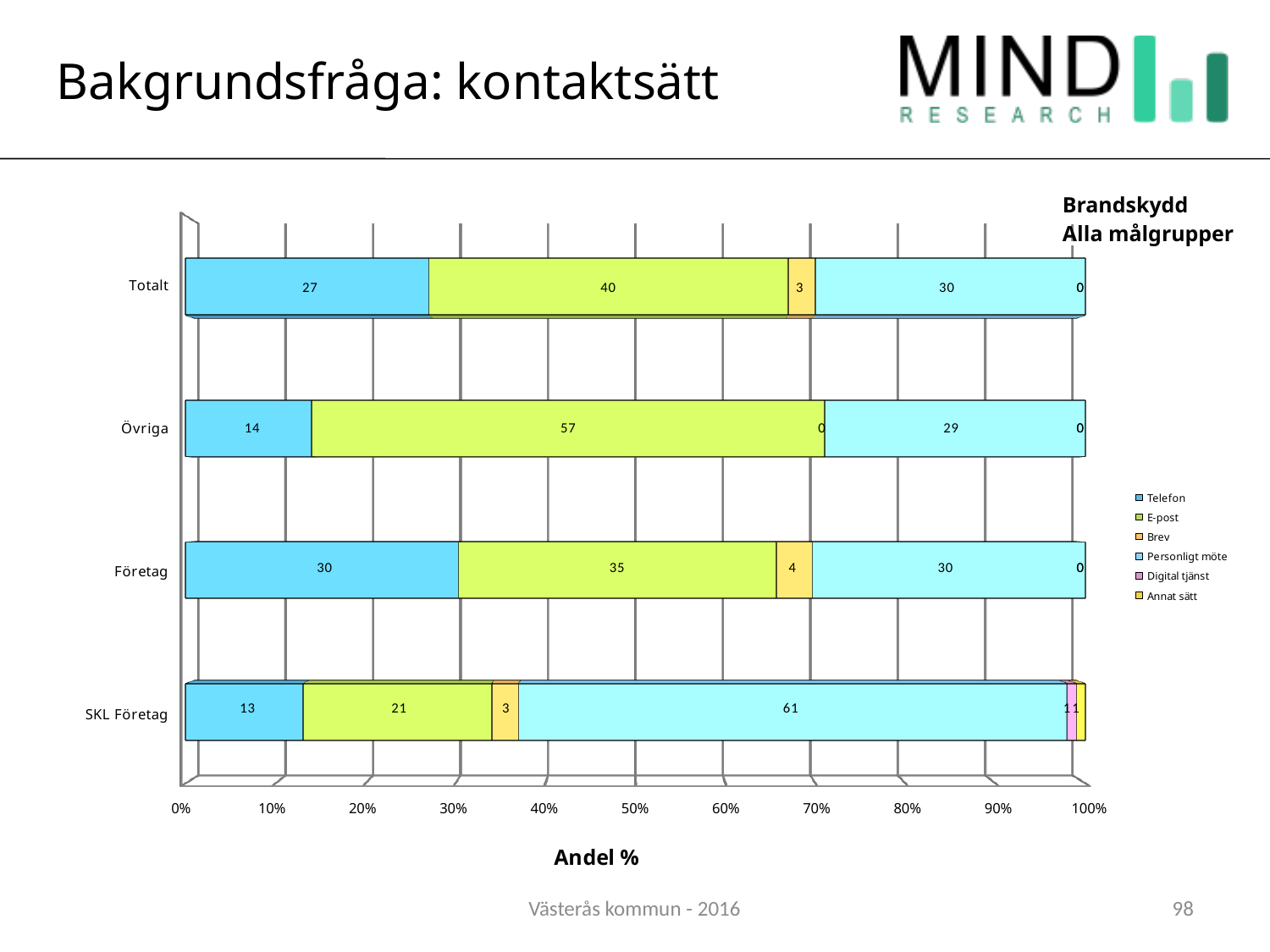
What is the E-post value for Övriga? 57 What kind of chart is shown on the slide? stacked bar chart Which category has the highest E-post value? Övriga What is the difference between the Telefon values for Företag and Övriga? 16 What is the Personligt möte value for SKL Företag? 61 What is the Telefon value for Totalt? 27 Which category has the lowest Telefon value? SKL Företag How many series does the legend list? 6 What is the Brev value for Företag? 4 Which is larger, the Personligt möte value for Totalt or for Övriga? Totalt What is the label of the x axis? Andel % How many categories are shown on the y axis? 4